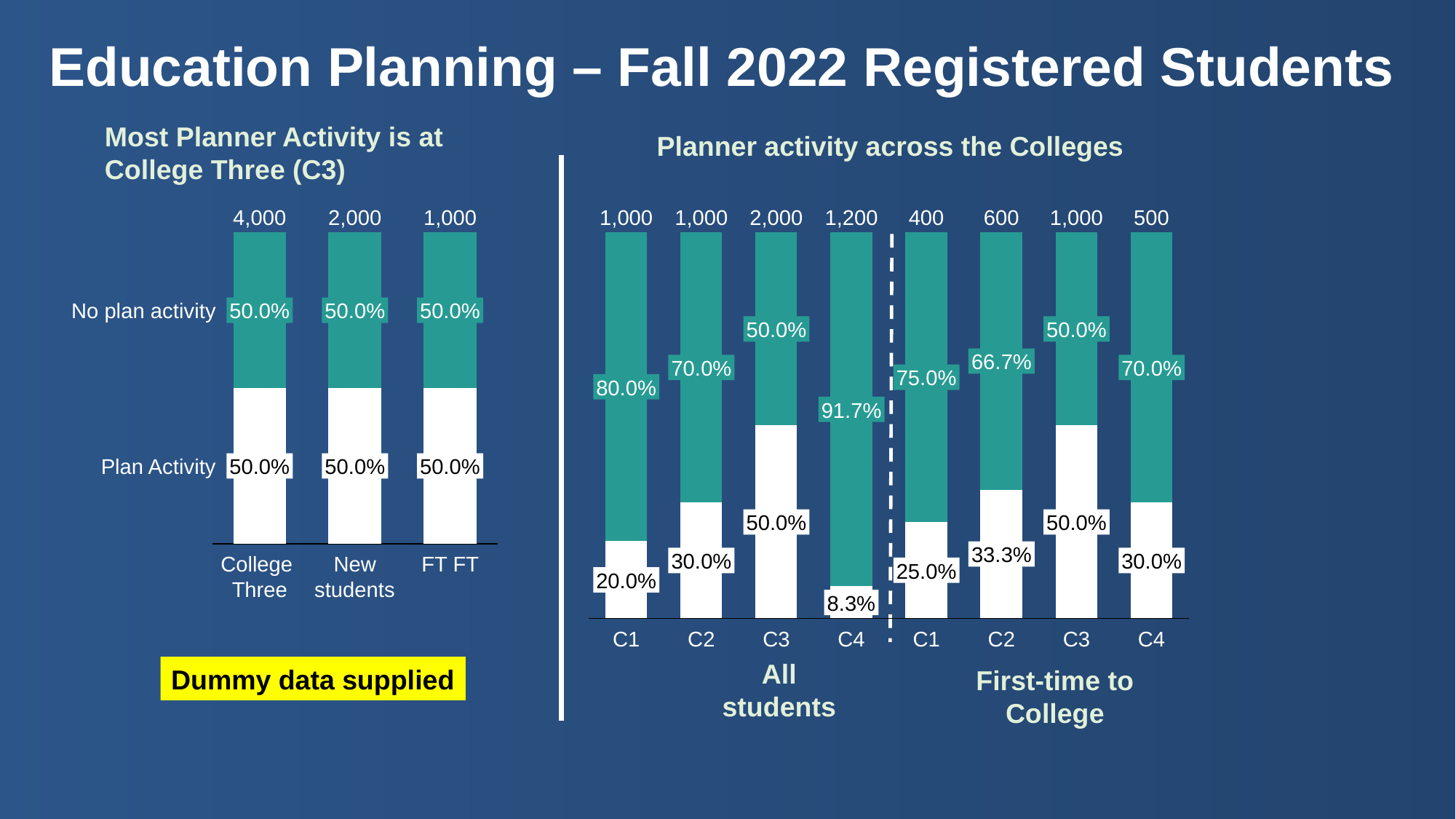
In the left chart 'Most Planner Activity is at College Three (C3)', which bar has the highest total printed above it? College Three In the right chart 'Planner activity across the Colleges', what is the No plan activity percentage for C2 among First-time to College students? 66.7% In the right chart 'Planner activity across the Colleges', which college has the lowest Plan Activity percentage among All students? C4 In the left chart 'Most Planner Activity is at College Three (C3)', what is the Plan Activity percentage for New students? 50.0% In the right chart 'Planner activity across the Colleges', what total is printed above the C3 bar in the First-time to College group? 1,000 In the right chart 'Planner activity across the Colleges', what is the difference between the Plan Activity percentages of C3 and C1 among All students? 30.0% In the left chart 'Most Planner Activity is at College Three (C3)', what total is printed above the College Three bar? 4,000 What kind of chart is the right chart 'Planner activity across the Colleges'? Stacked bar chart In the left chart 'Most Planner Activity is at College Three (C3)', how many bars are shown? 3 In the right chart 'Planner activity across the Colleges', what is the Plan Activity percentage for C4 among All students? 8.3% In the right chart 'Planner activity across the Colleges', which is larger: the Plan Activity percentage for C2 among All students or for C2 among First-time to College students? C2 among First-time to College (33.3%) In the right chart 'Planner activity across the Colleges', which college has the highest Plan Activity percentage among All students? C3